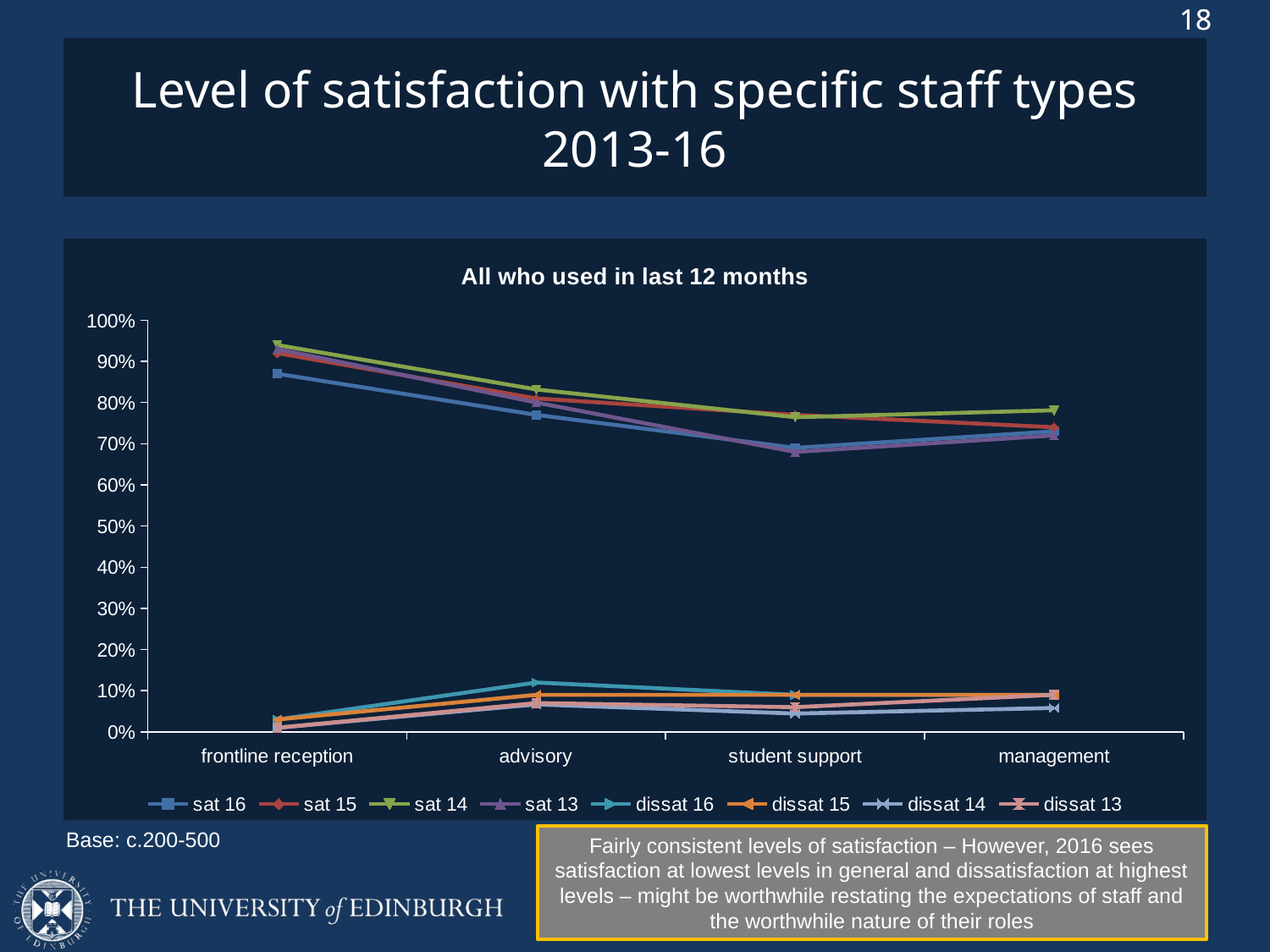
Is the value for sat 14 at frontline reception greater or less than 90%? greater At frontline reception, which is larger: sat 14 or sat 16? sat 14 What kind of chart is shown on the slide? line chart Is the value for sat 16 at frontline reception greater or less than 90%? less Which category on the x axis is listed last? management Does the sat 16 line rise or fall from frontline reception to student support? fall How many series does the legend list? 8 How many staff type categories are shown on the x axis? 4 Is the value for sat 13 at student support greater or less than 80%? less What is the title printed above the chart? All who used in last 12 months